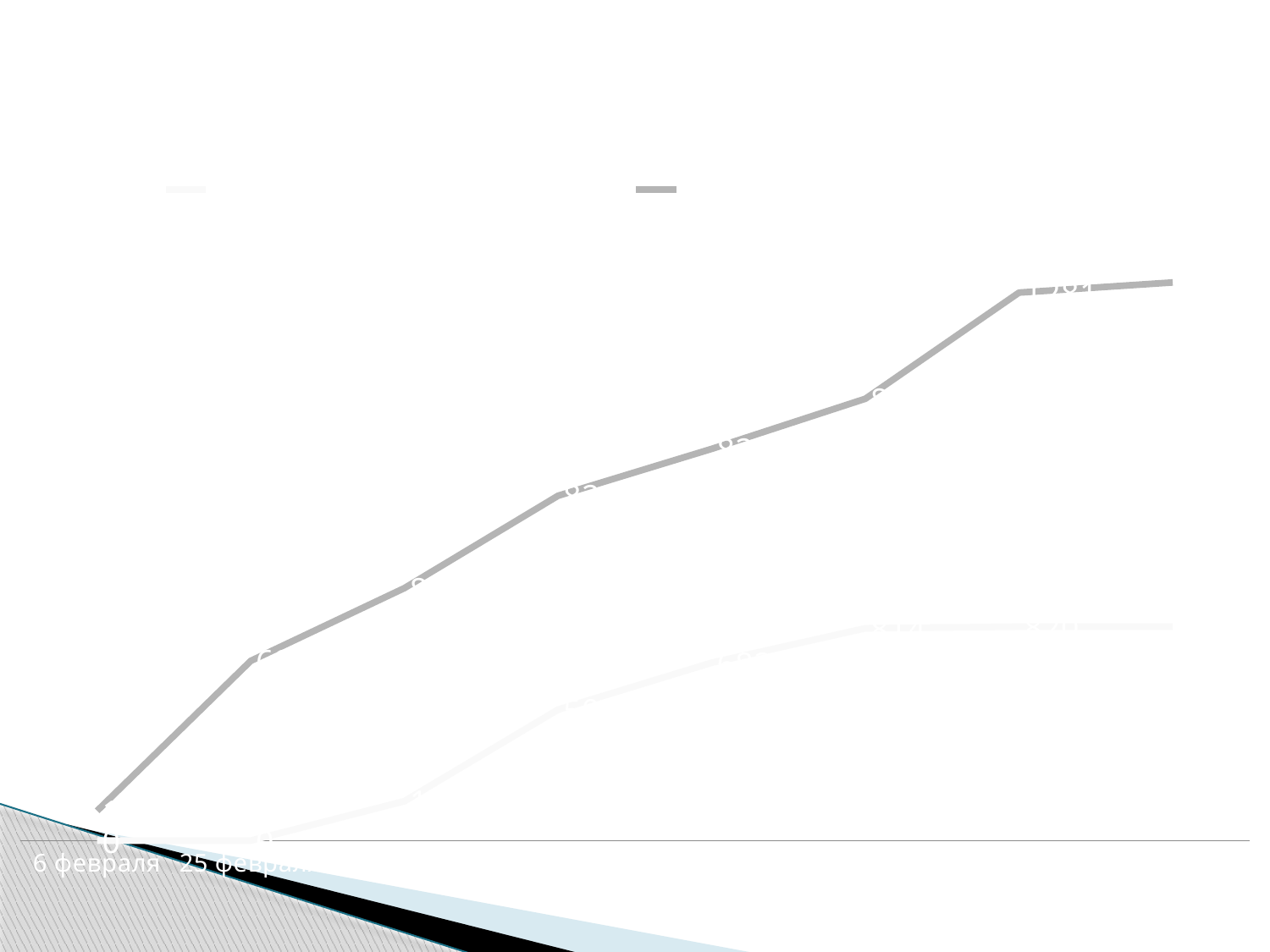
Which line is higher at 25 февраля, the grey line or the white line? the grey line Which line reaches the higher value at the right end of the chart, the grey line or the white line? the grey line What is the first category label on the x axis? 6 февраля How many series does the legend list? 2 How many data points does the grey line have? 8 What kind of chart is shown on the slide? line chart Does the grey line rise or fall from left to right along the x axis? rise